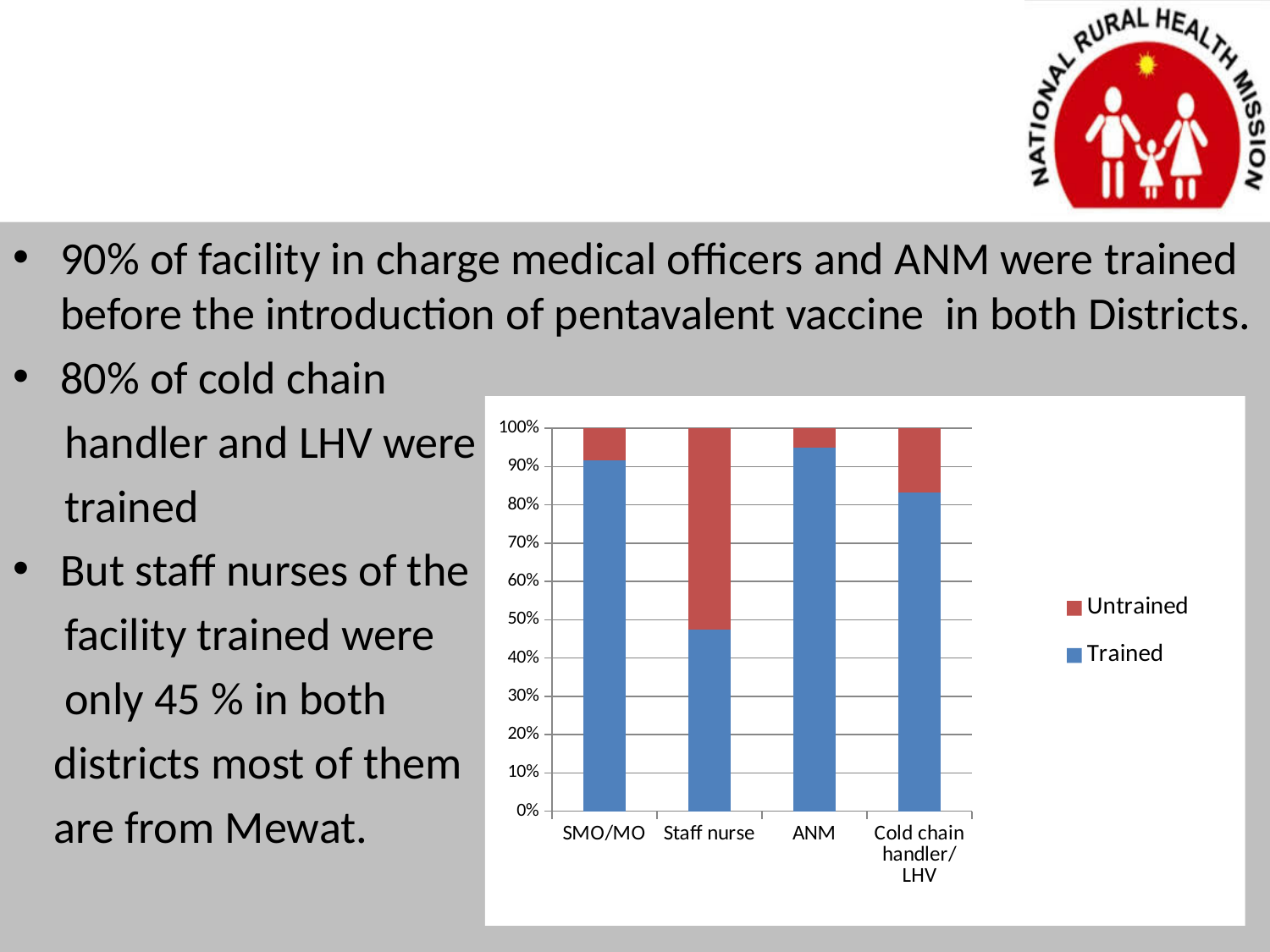
What kind of chart is shown on the slide? Stacked bar chart What colour represents the Untrained series in the chart? Red Is the Trained value for Cold chain handler/LHV greater or less than 80%? greater Which category has the lowest Trained share? Staff nurse How many series does the chart legend list? 2 How many categories are shown on the x axis of the chart? 4 Is the Trained value for Staff nurse greater or less than 50%? less What are the two series named in the chart legend? Untrained and Trained Which category has the largest Untrained share? Staff nurse Which has a larger Trained share, Staff nurse or Cold chain handler/LHV? Cold chain handler/LHV Is the Trained value for SMO/MO greater or less than 90%? greater